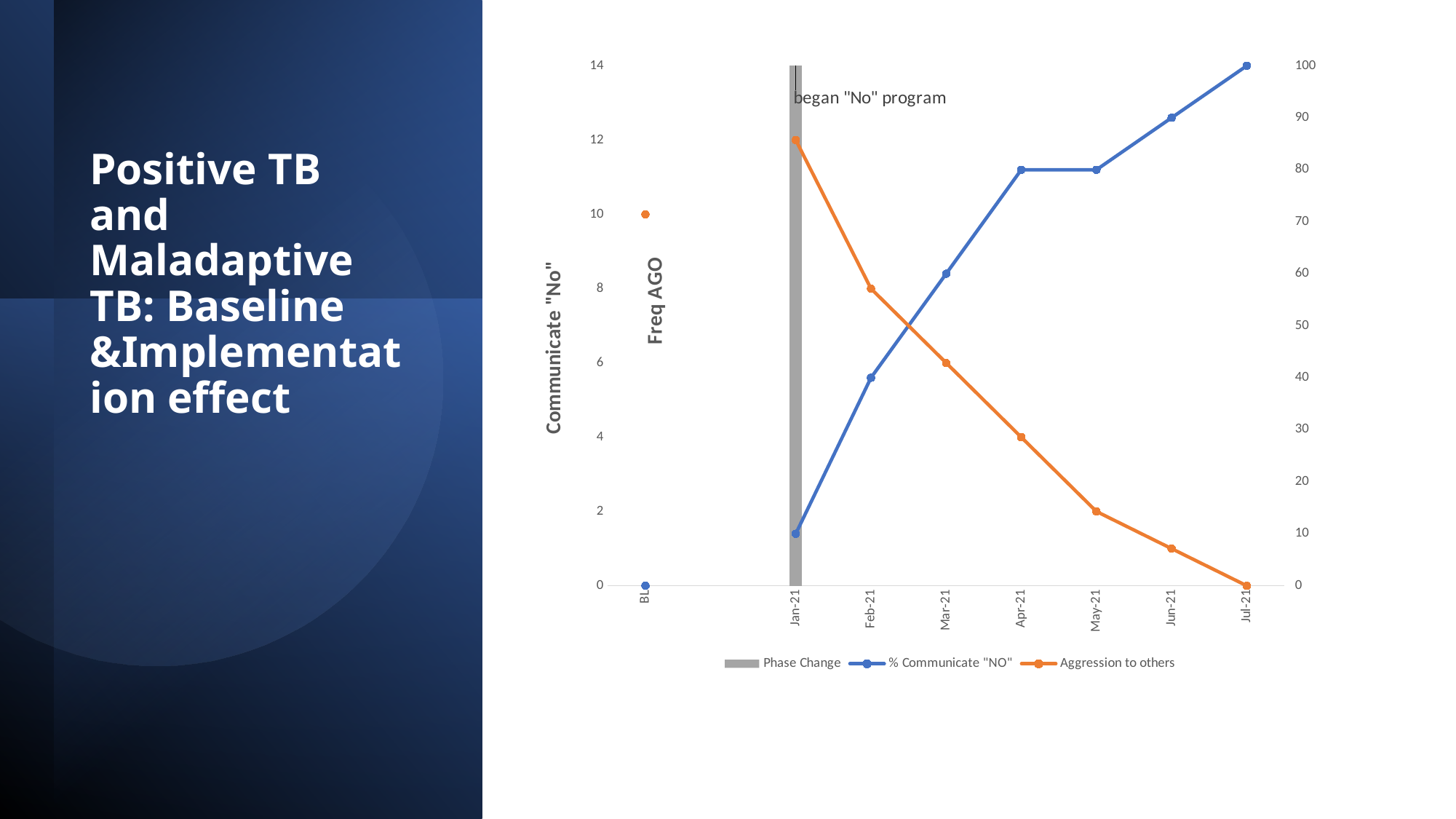
What kind of chart is shown on the slide? combination bar and line chart Is the value of % Communicate "NO" at Feb-21 greater or less than 50 on the right axis? less How many categories are shown on the x axis? 8 Does Aggression to others rise or fall from Jan-21 to Jul-21? fall What is the value of % Communicate "NO" at Jul-21 on the right axis? 100 How many series does the legend list? 3 At which category is Aggression to others highest? Jan-21 What is the value of Aggression to others at Jan-21 on the left axis? 12 At which category is % Communicate "NO" lowest? BL What is the value of Aggression to others at Jul-21? 0 What text is annotated next to the grey Phase Change bar? began "No" program What is the value of % Communicate "NO" at BL? 0